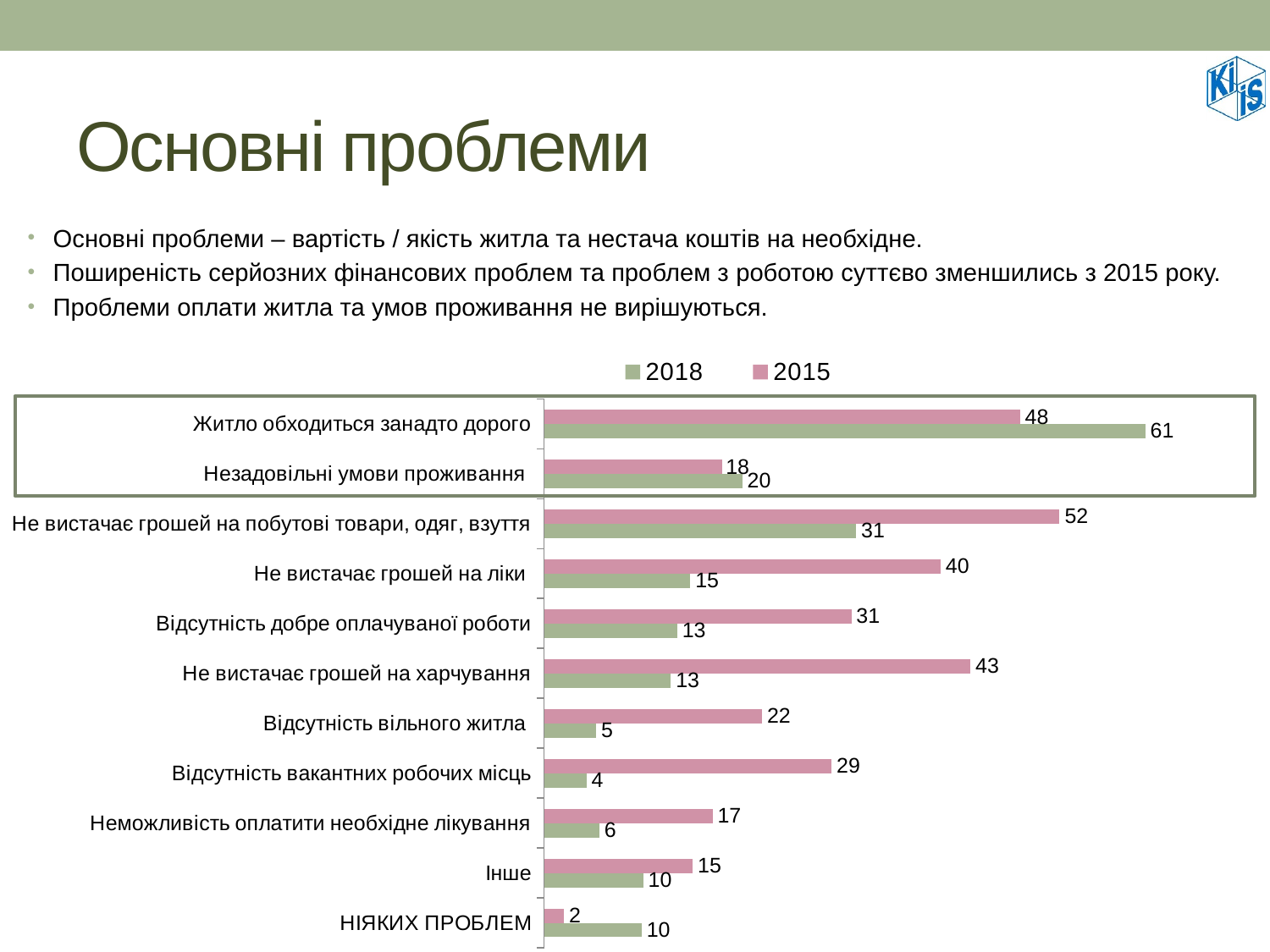
Which category has the highest 2018 value? Житло обходиться занадто дорого Which category has the lowest 2015 value? НІЯКИХ ПРОБЛЕМ How many series does the legend list? 2 What is the 2018 value for "Житло обходиться занадто дорого"? 61 What type of chart is shown on the slide? Bar chart Which is larger for "Відсутність вільного житла": the 2018 value or the 2015 value? 2015 What is the 2015 value for "Не вистачає грошей на харчування"? 43 What is the difference between the 2015 and 2018 values for "Не вистачає грошей на ліки"? 25 Which is larger for "НІЯКИХ ПРОБЛЕМ": the 2018 value or the 2015 value? 2018 How many categories are shown in the chart? 11 What is the 2018 value for "Відсутність вакантних робочих місць"? 4 Which category has the highest 2015 value? Не вистачає грошей на побутові товари, одяг, взуття